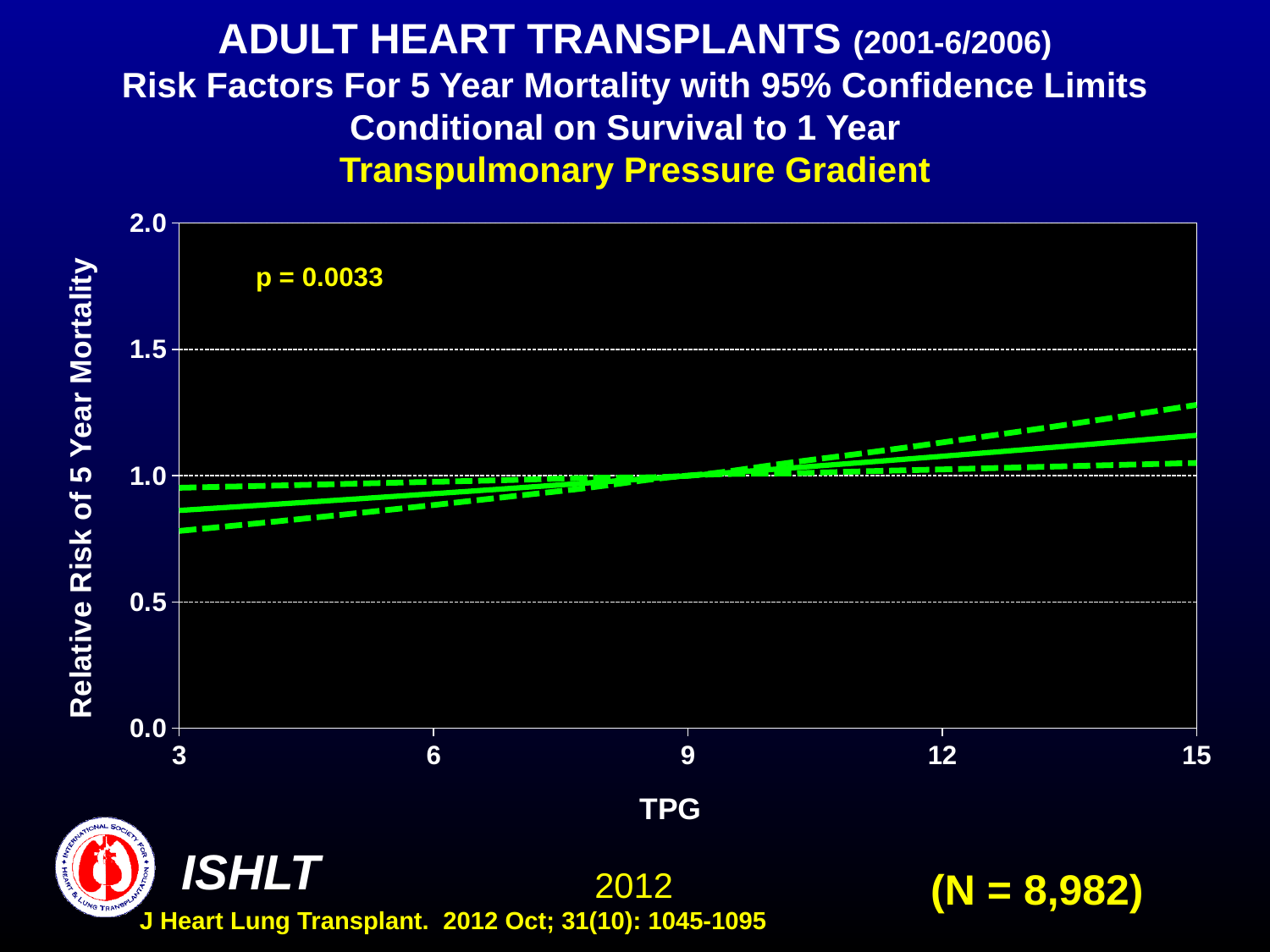
How many lines are plotted on the chart? 3 Is the relative risk of 5 year mortality at a TPG of 3 greater or less than 1.0? less What is the sample size (N) shown on the slide? N = 8,982 Is the relative risk of 5 year mortality at a TPG of 15 greater or less than 1.5? less What p-value is printed on the chart? p = 0.0033 Is the relative risk of 5 year mortality at a TPG of 15 greater or less than 1.0? greater What kind of chart is shown on the slide? line chart Is the relative risk at a TPG of 15 larger or smaller than the relative risk at a TPG of 3? larger What is the label of the x axis? TPG Does the relative risk of 5 year mortality rise or fall as TPG increases from 3 to 15? rise